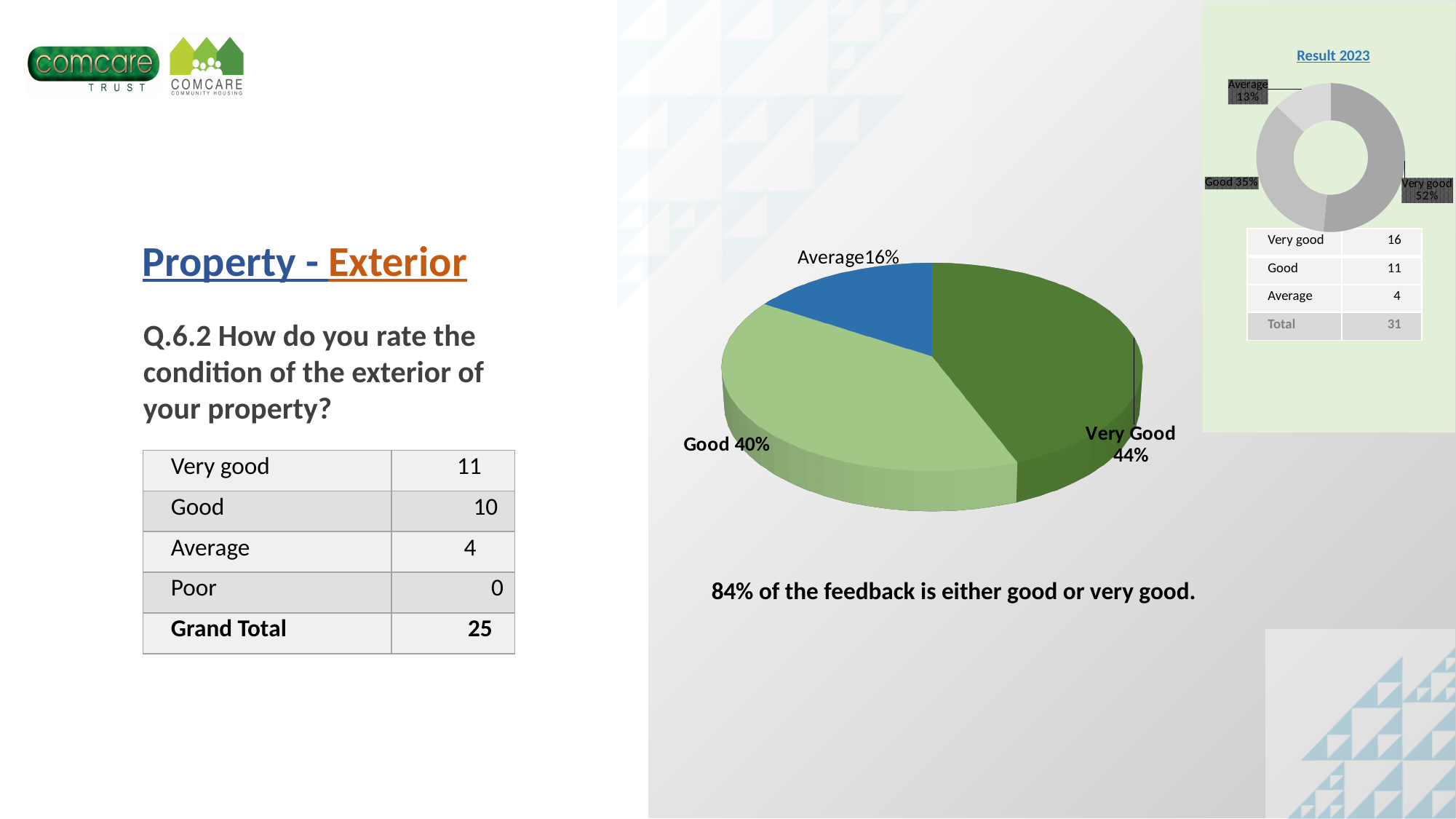
In the large pie chart in the centre of the slide, what share is labelled for Good? 40% In the large pie chart in the centre of the slide, which category has the largest slice? Very Good What is the difference between the Very good share in the 'Result 2023' chart and the Very Good share in the large centre pie chart? 8% In the large pie chart in the centre of the slide, what share is labelled for Average? 16% In the 'Result 2023' chart at the top right, what share is labelled for Good? 35% In the large pie chart in the centre of the slide, what share is labelled for Very Good? 44% In the large pie chart in the centre of the slide, which category has the smallest slice? Average In the 'Result 2023' chart at the top right, what share is labelled for Average? 13% In the 'Result 2023' chart at the top right, what share is labelled for Very good? 52% In the large pie chart in the centre of the slide, how many slices are shown? 3 In the 'Result 2023' chart at the top right, which category has the largest share? Very good What kind of chart is the large chart in the centre of the slide? Pie chart